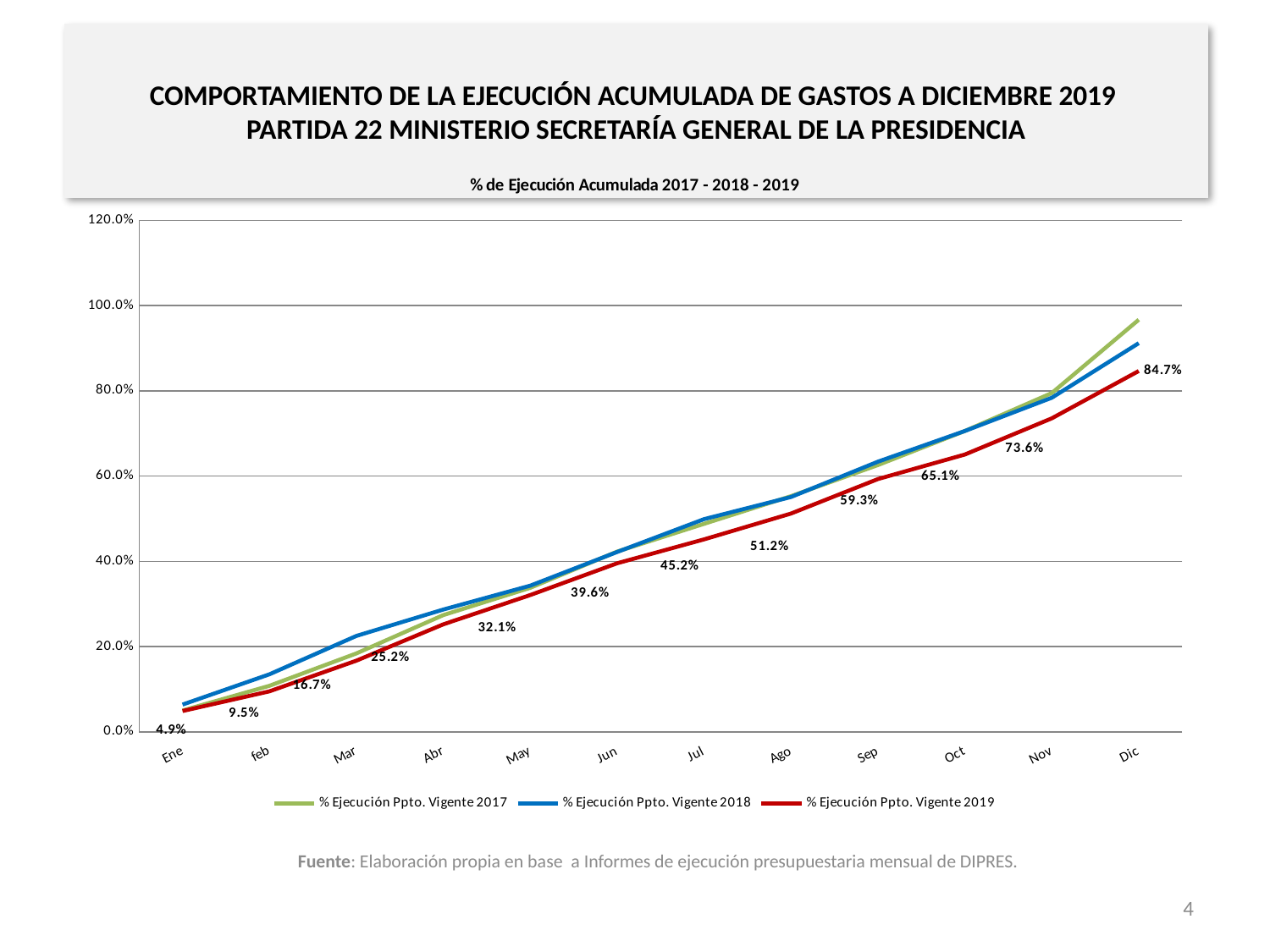
What is the value of % Ejecución Ppto. Vigente 2019 in Ene? 4.9% What is the value of % Ejecución Ppto. Vigente 2019 in Jun? 39.6% What is the value of % Ejecución Ppto. Vigente 2019 in Sep? 59.3% Which series has the higher value in Dic, 2017 or 2019? % Ejecución Ppto. Vigente 2017 What is the value of % Ejecución Ppto. Vigente 2019 in Dic? 84.7% What is the difference between the 2019 values for Dic and Nov? 11.1% What kind of chart is shown on the slide? line chart In which month is the 2019 series at its lowest? Ene How many series does the legend list? 3 Is the value for % Ejecución Ppto. Vigente 2018 in Dic greater or less than 80.0%? greater Does the 2019 series rise or fall from Ene to Dic? rise How many months are plotted along the x axis? 12